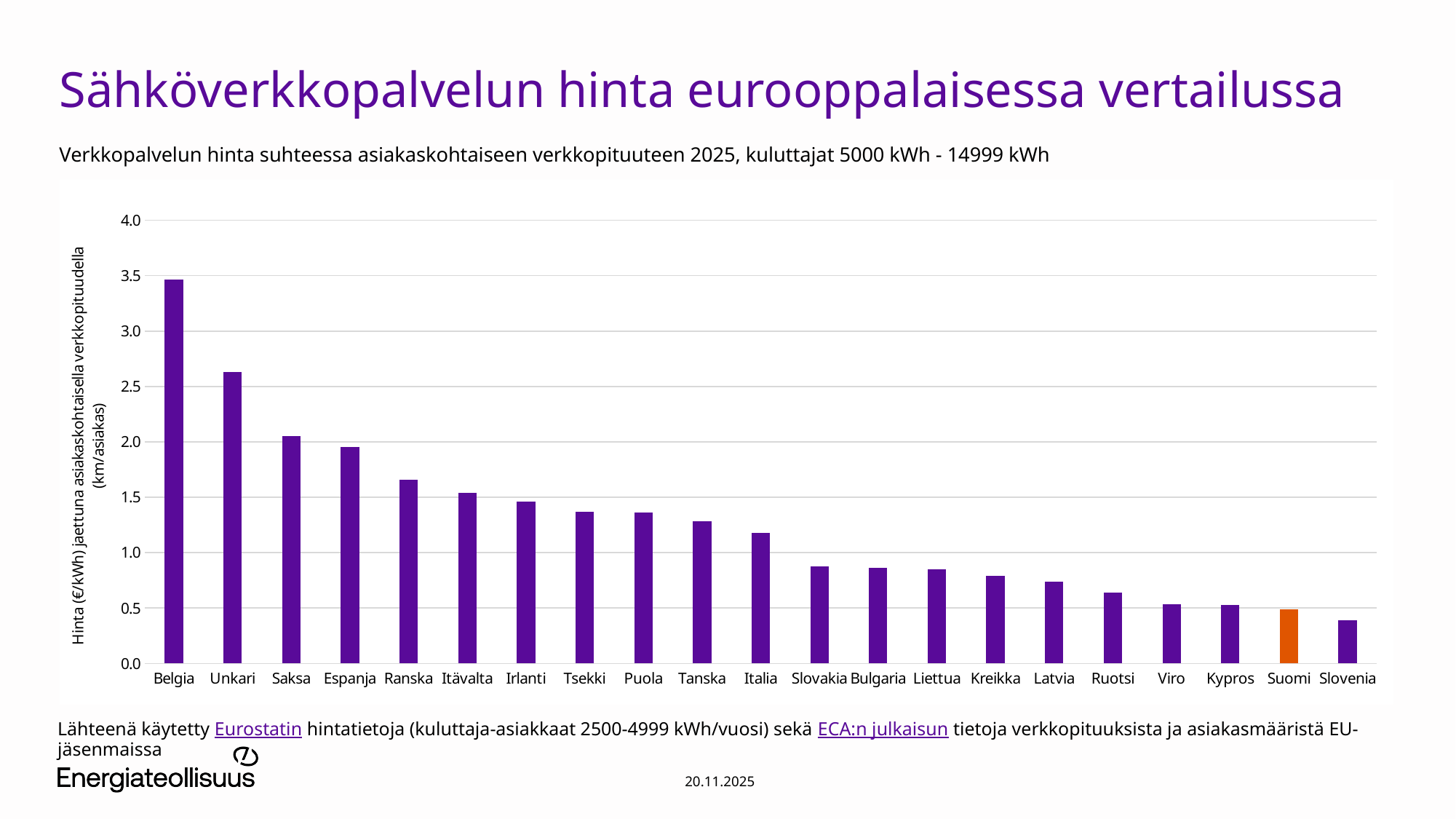
Is the value for Slovenia greater or less than 0.5? less Which country has the lowest value in the chart? Slovenia What kind of chart is shown on the slide? bar chart Is the value for Unkari greater or less than 2.5? greater Is the value for Ranska greater or less than 1.5? greater Do the values rise or fall from left to right along the x axis? fall Which country's bar is highlighted in orange? Suomi Which has a larger value, Saksa or Italia? Saksa How many countries are shown in the chart? 21 Which country has the highest value in the chart? Belgia